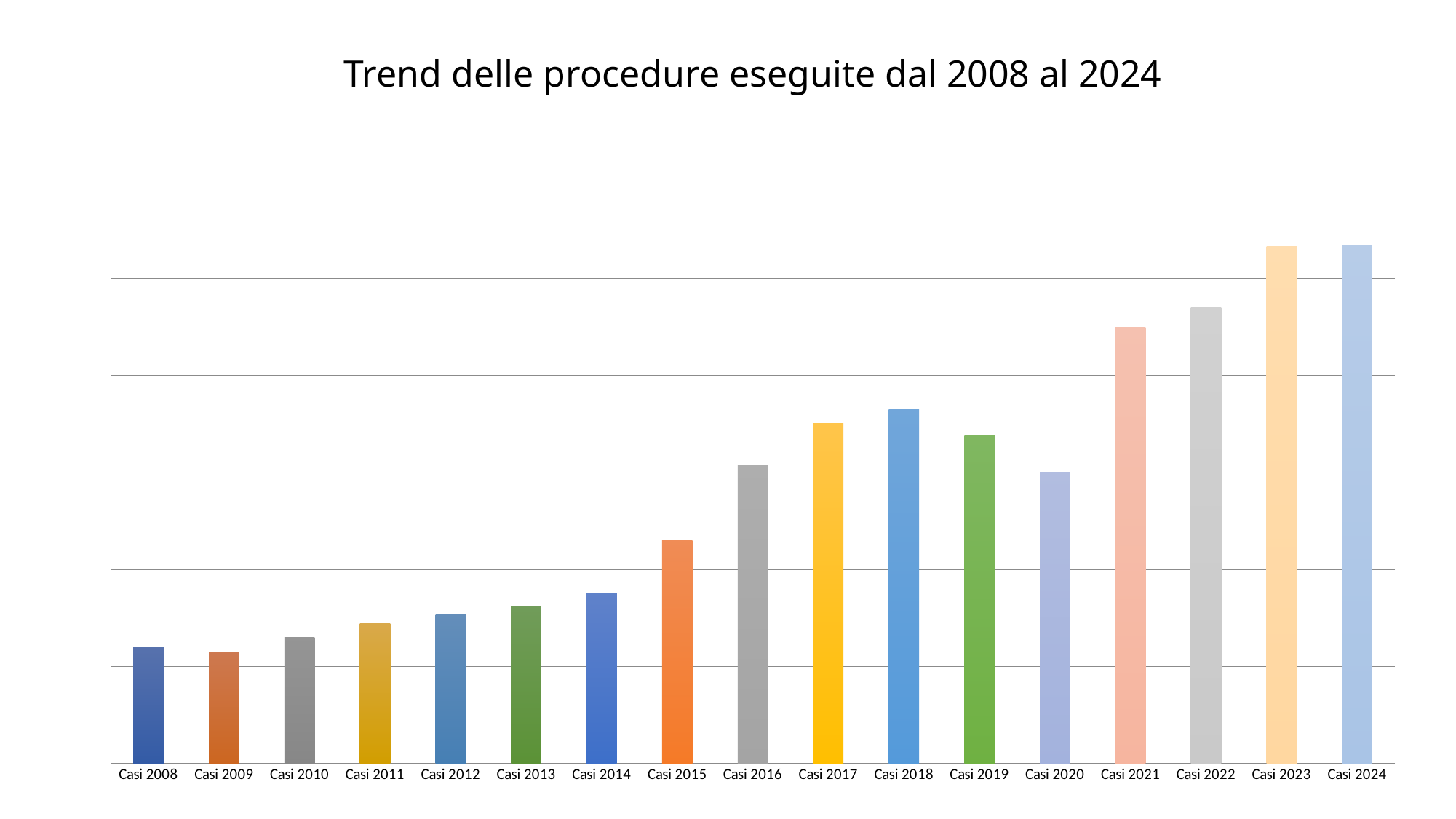
What is the label of the first category on the x axis? Casi 2008 Which is larger, the value for Casi 2015 or the value for Casi 2016? Casi 2016 Which is larger, the value for Casi 2012 or the value for Casi 2014? Casi 2014 What is the title of the chart? Trend delle procedure eseguite dal 2008 al 2024 How many categories (years) are plotted on the x axis? 17 What kind of chart is shown on the slide? bar chart Which is larger, the value for Casi 2018 or the value for Casi 2019? Casi 2018 Do the values generally rise or fall from Casi 2008 to Casi 2024? rise